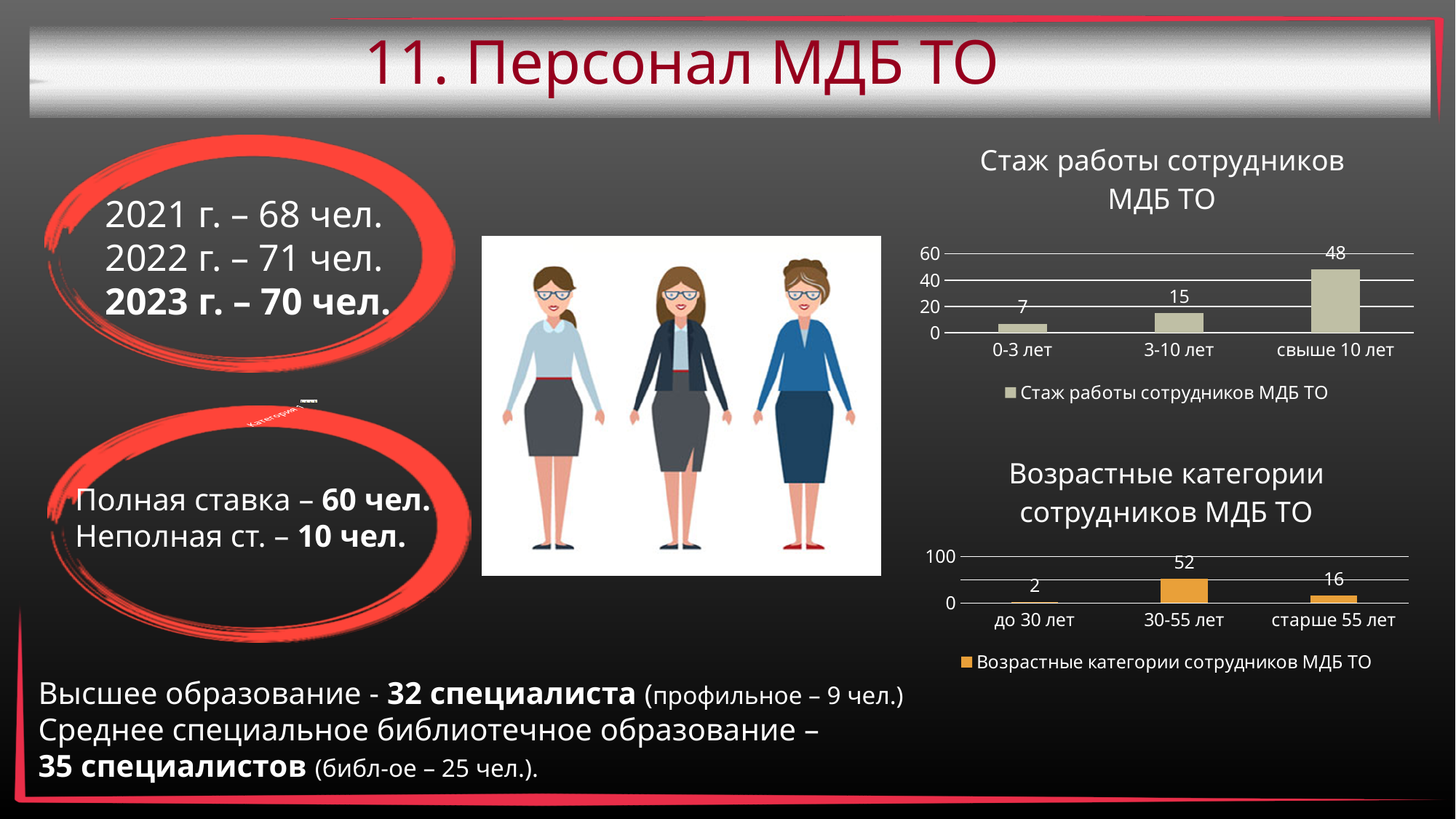
In the chart 'Стаж работы сотрудников МДБ ТО', what is the difference between 'свыше 10 лет' and '3-10 лет'? 33 In the chart 'Стаж работы сотрудников МДБ ТО', how many categories are shown on the x axis? 3 In the chart 'Возрастные категории сотрудников МДБ ТО', what is the difference between '30-55 лет' and 'до 30 лет'? 50 In the chart 'Стаж работы сотрудников МДБ ТО', do the values rise or fall from left to right along the x axis? rise In the chart 'Возрастные категории сотрудников МДБ ТО', which category has the lowest value? до 30 лет In the chart 'Возрастные категории сотрудников МДБ ТО', which is larger: '30-55 лет' or 'старше 55 лет'? 30-55 лет In the chart 'Стаж работы сотрудников МДБ ТО', which category has the highest value? свыше 10 лет In the chart 'Стаж работы сотрудников МДБ ТО', what is the value for '0-3 лет'? 7 In the chart 'Возрастные категории сотрудников МДБ ТО', what is the value for 'старше 55 лет'? 16 In the chart 'Стаж работы сотрудников МДБ ТО', what is the value for 'свыше 10 лет'? 48 What type of chart is 'Возрастные категории сотрудников МДБ ТО'? bar chart In the chart 'Возрастные категории сотрудников МДБ ТО', what is the value for '30-55 лет'? 52